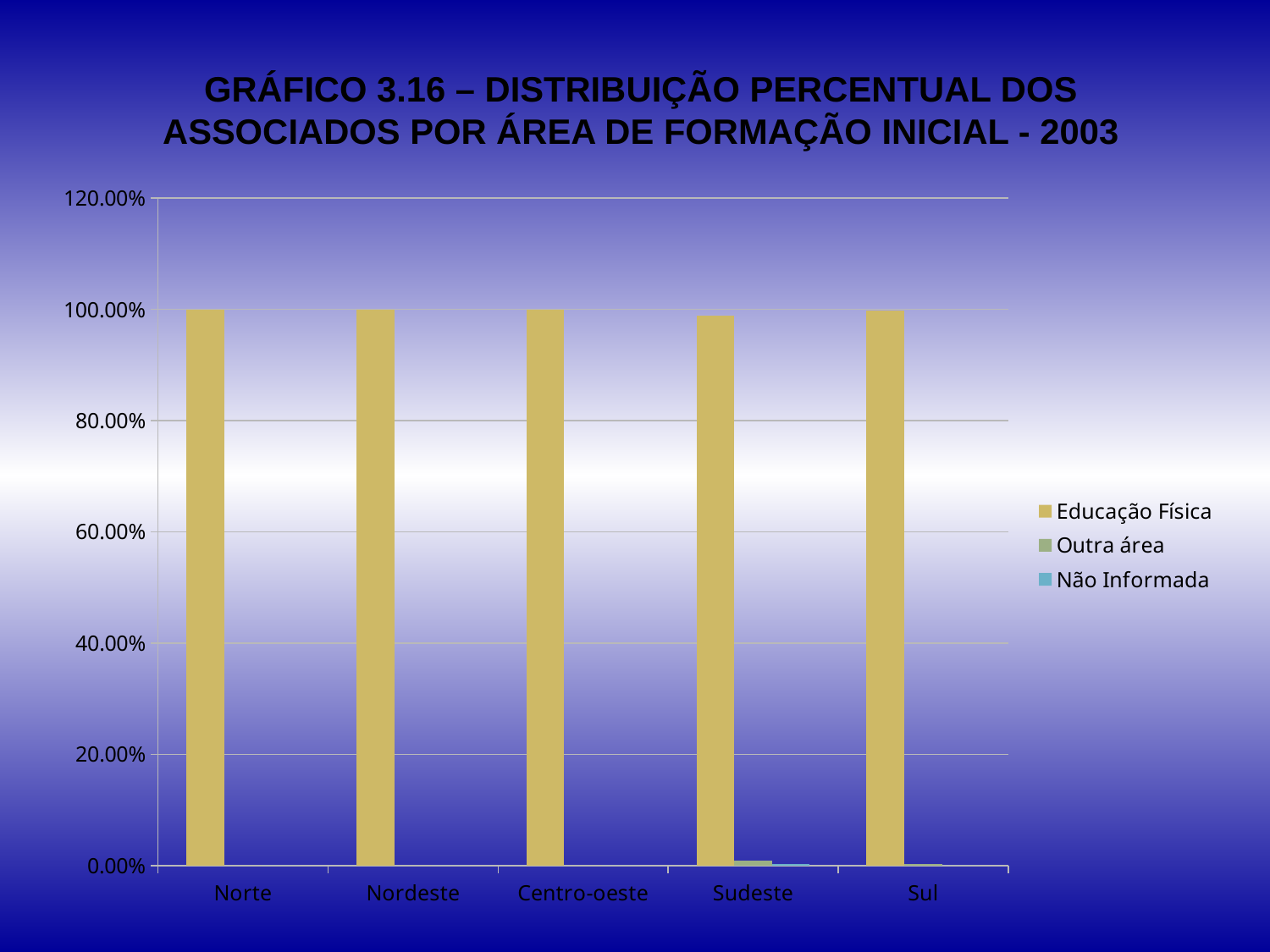
Is the Educação Física value for Sudeste greater or less than 60.00%? greater Which series are listed in the legend? Educação Física, Outra área, Não Informada How many series does the legend list? 3 What kind of chart is shown on the slide? bar chart Which region has the lowest Educação Física value? Sudeste What year does the chart title refer to? 2003 What is the Educação Física value for Norte? 100.00% Which is larger, the Educação Física value for Norte or for Sudeste? Norte Which series has the tallest bars in every region? Educação Física Is the Outra área value for Sudeste greater or less than 20.00%? less Is the Educação Física value for Norte greater or less than 80.00%? greater How many regions (categories) are shown on the x axis? 5